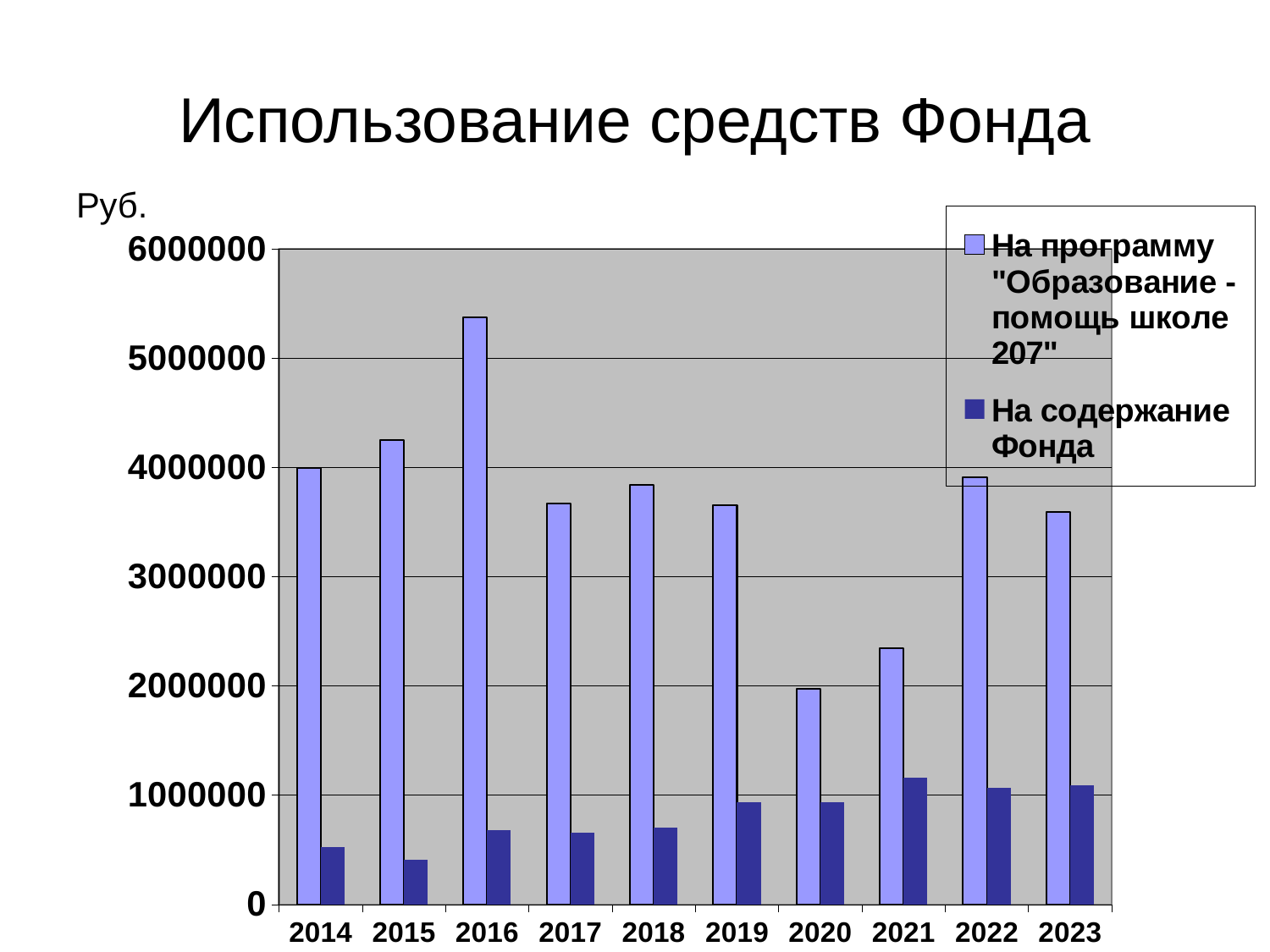
Is the 2021 value for "На программу "Образование - помощь школе 207"" greater or less than 2000000? greater In which year is the value for "На содержание Фонда" the highest? 2021 Is the 2016 value for "На программу "Образование - помощь школе 207"" greater or less than 5000000? greater What unit label is shown above the vertical axis of the chart? Руб. Which is larger: the 2016 or the 2015 value for "На программу "Образование - помощь школе 207""? 2016 What type of chart is shown on the slide? bar chart In which year is the value for "На программу "Образование - помощь школе 207"" the highest? 2016 In which year is the value for "На содержание Фонда" the lowest? 2015 How many years are shown on the x axis of the chart? 10 How many series does the legend list? 2 Is the 2015 value for "На содержание Фонда" greater or less than 1000000? less In which year is the value for "На программу "Образование - помощь школе 207"" the lowest? 2020